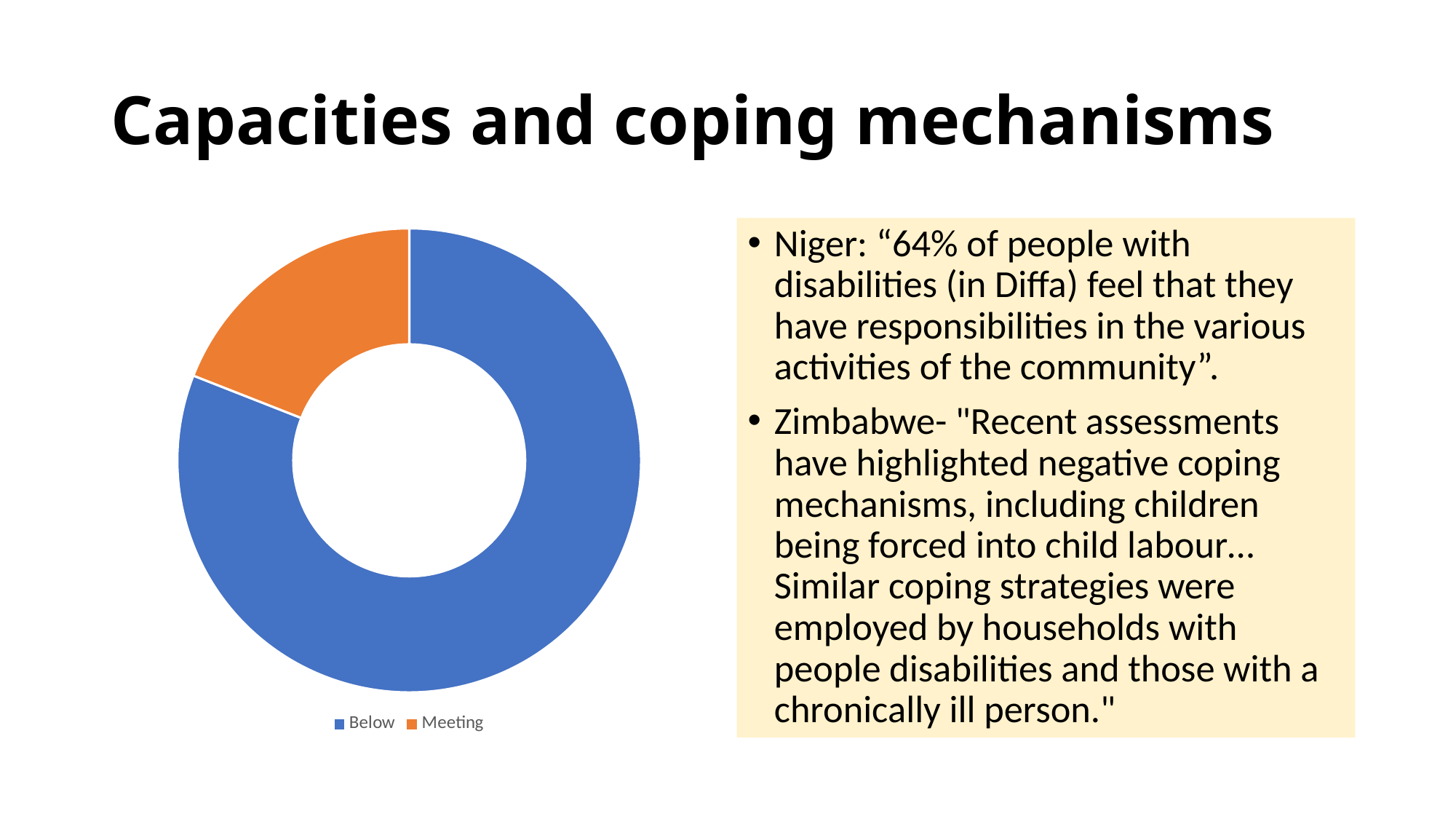
What colour represents the Meeting category in the doughnut chart? orange Is the share for Below greater or less than half of the doughnut chart? greater What colour represents the Below category in the doughnut chart? blue What kind of chart is shown on the slide? doughnut chart Is the share for Meeting greater or less than half of the doughnut chart? less How many entries does the chart legend list? 2 Which category takes up the smallest share of the doughnut chart? Meeting How many categories does the doughnut chart show? 2 Which category takes up the largest share of the doughnut chart? Below Which is larger in the doughnut chart, Below or Meeting? Below